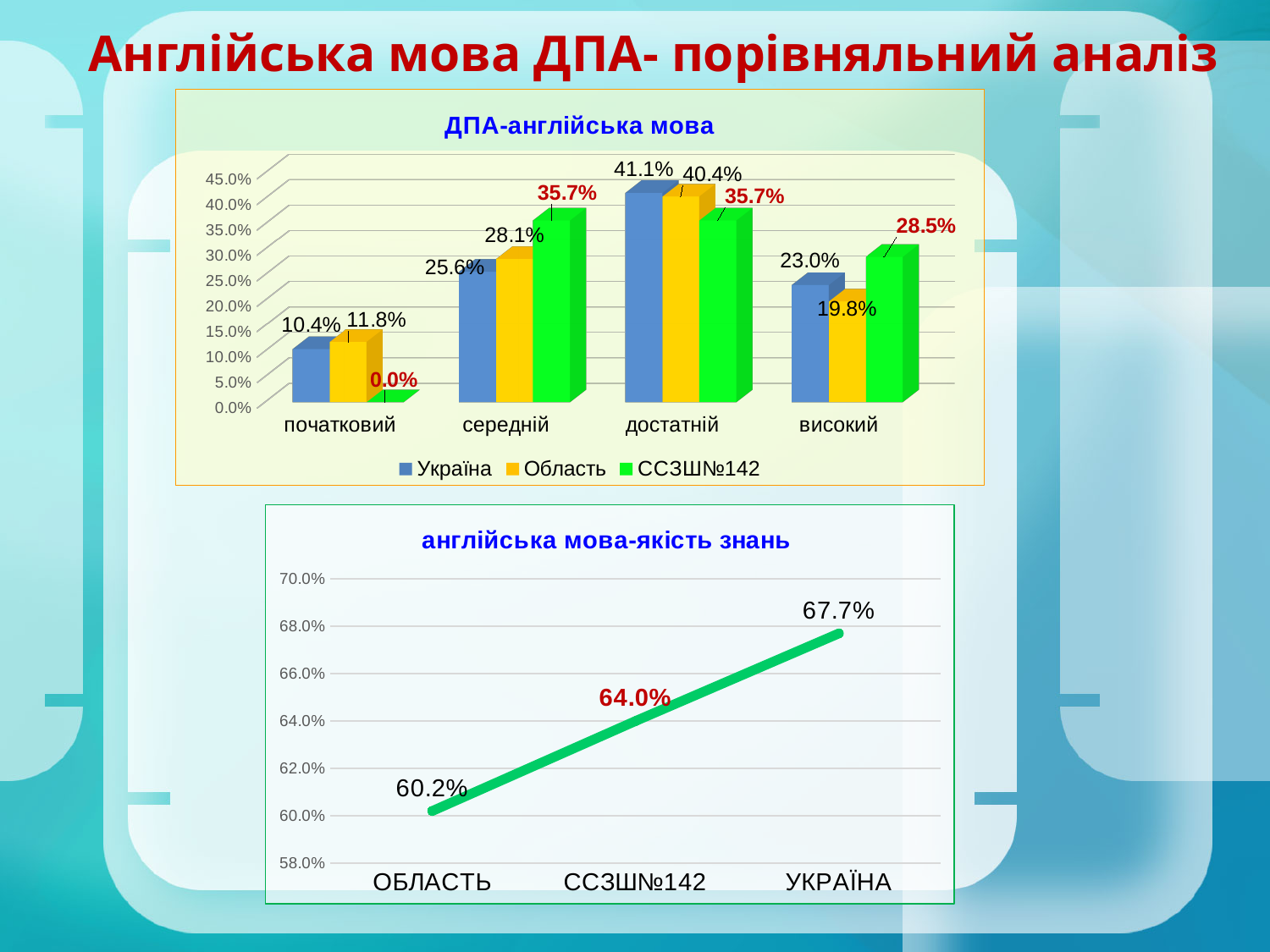
In the chart titled "ДПА-англійська мова", how many categories are shown on the x axis? 4 In the chart titled "ДПА-англійська мова", how many series does the legend list? 3 In the chart titled "ДПА-англійська мова", what is the difference between the ССЗШ№142 and Україна values in the "високий" category? 5.5% What kind of chart is the chart titled "англійська мова-якість знань"? line chart In the chart titled "ДПА-англійська мова", what is the value for Україна in the "достатній" category? 41.1% In the chart titled "англійська мова-якість знань", what is the value for ССЗШ№142? 64.0% In the chart titled "ДПА-англійська мова", which category has the highest value for Україна? достатній In the chart titled "англійська мова-якість знань", what is the difference between the values for УКРАЇНА and ОБЛАСТЬ? 7.5% In the chart titled "ДПА-англійська мова", which is larger in the "середній" category: Україна or Область? Область In the chart titled "ДПА-англійська мова", what is the value for Область in the "високий" category? 19.8% In the chart titled "ДПА-англійська мова", what is the value for ССЗШ№142 in the "середній" category? 35.7% In the chart titled "ДПА-англійська мова", which category has the lowest value for ССЗШ№142? початковий